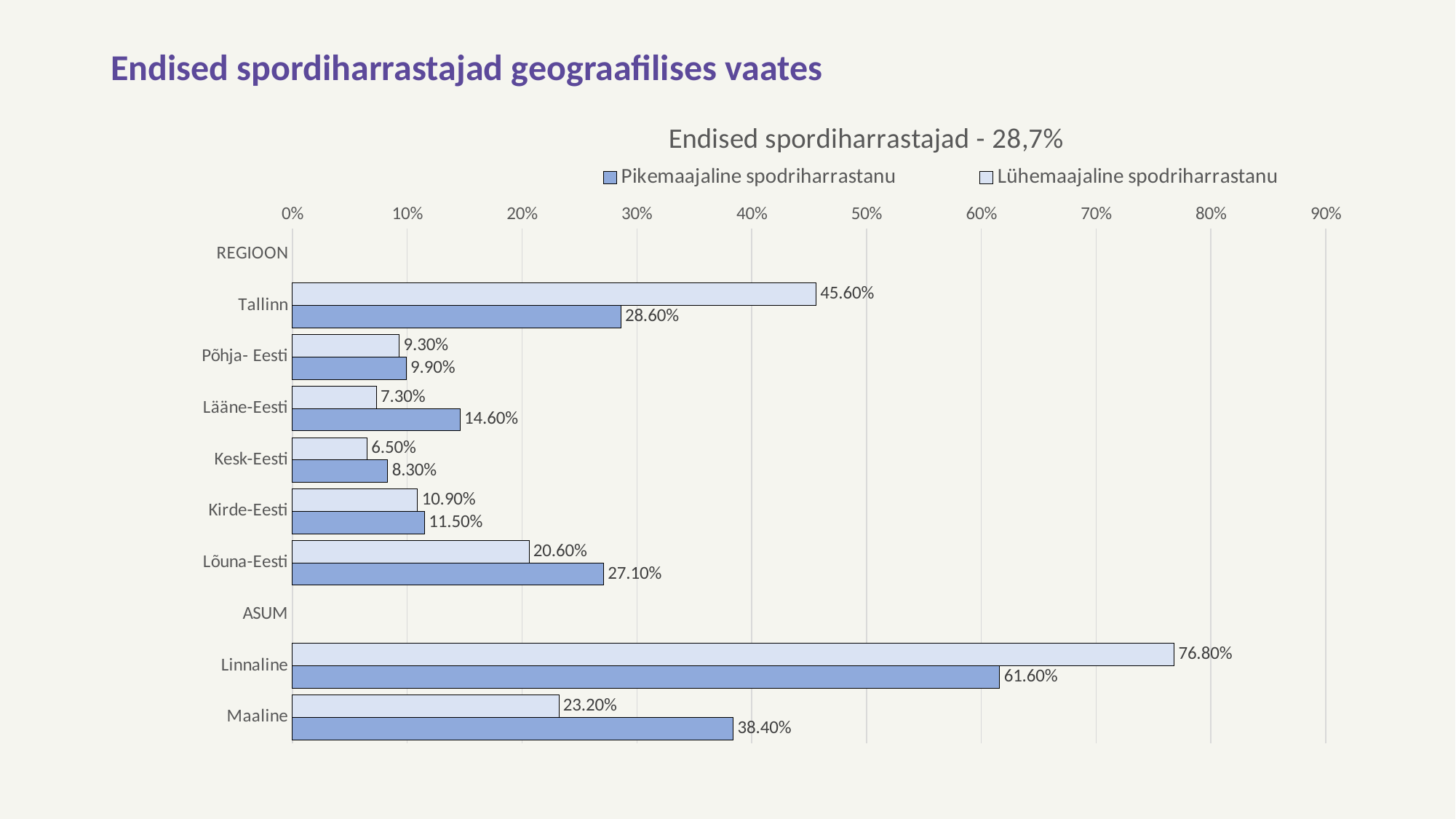
Which category has the highest value in the Pikemaajaline spodriharrastanu series? Linnaline What is the title of the chart? Endised spordiharrastajad - 28,7% What is the value for Maaline in the Pikemaajaline spodriharrastanu series? 38.40% What is the value for Tallinn in the Lühemaajaline spodriharrastanu series? 45.60% Is the value for Linnaline in the Lühemaajaline spodriharrastanu series greater or less than 70%? greater Which category has the lowest value in the Lühemaajaline spodriharrastanu series? Kesk-Eesti For Lääne-Eesti, which series has the larger value: Pikemaajaline spodriharrastanu or Lühemaajaline spodriharrastanu? Pikemaajaline spodriharrastanu What kind of chart is shown on the slide? bar chart What is the difference between the Lühemaajaline spodriharrastanu and Pikemaajaline spodriharrastanu values for Tallinn? 17.00% How many series does the chart legend list? 2 How many regions are listed under the REGIOON group? 6 What is the value for Kesk-Eesti in the Lühemaajaline spodriharrastanu series? 6.50%